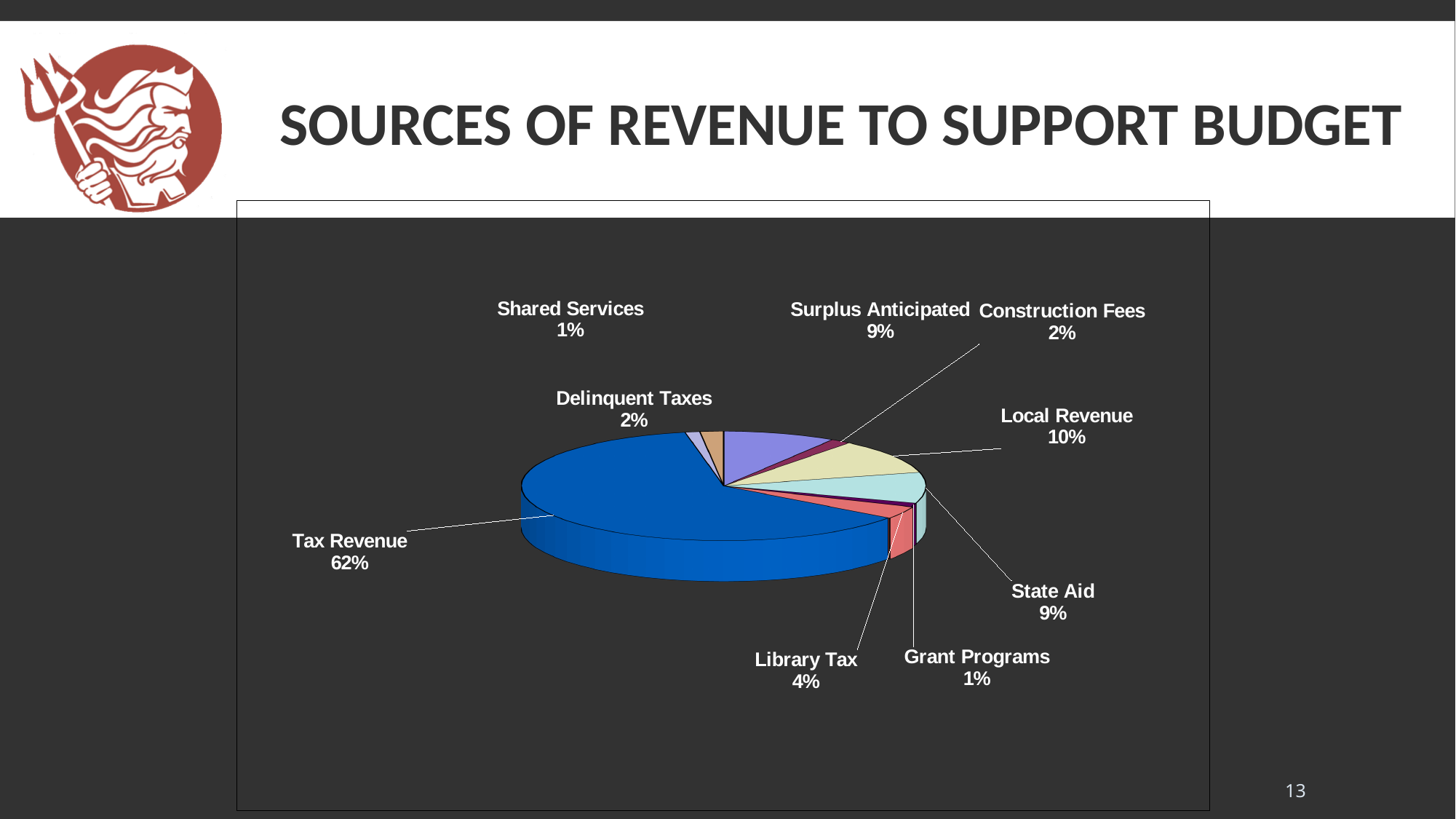
What share of revenue comes from Tax Revenue? 62% What percentage is shown for Library Tax? 4% Which revenue source has the largest share of the pie? Tax Revenue What is the difference in percentage points between Tax Revenue and Local Revenue? 52 What kind of chart is shown on the slide? Pie chart What is the value shown for Surplus Anticipated? 9% What is the combined percentage of Surplus Anticipated and State Aid? 18% Which is larger, Local Revenue or State Aid? Local Revenue What percentage of the pie is Local Revenue? 10% What is the title of the slide containing the chart? SOURCES OF REVENUE TO SUPPORT BUDGET Which is larger, Library Tax or Construction Fees? Library Tax How many revenue categories are shown in the pie chart? 9